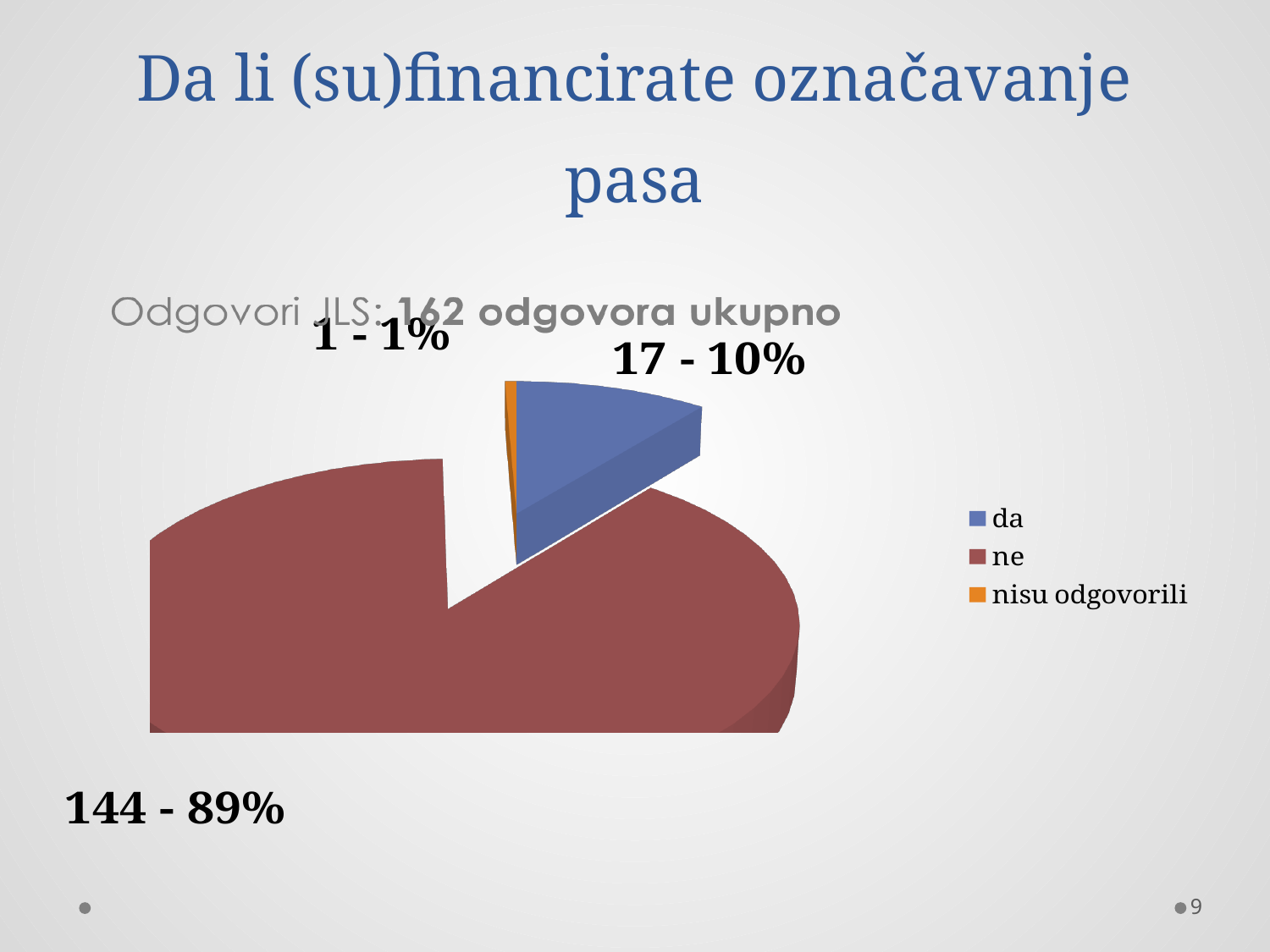
What is the count and percentage shown for the 'nisu odgovorili' slice? 1 - 1% What kind of chart is shown on the slide? pie chart What share of the pie does the 'da' slice represent? 10% Which category has the smallest slice of the pie? nisu odgovorili What colour is the 'ne' slice in the pie chart? dark red What is the difference in count between the 'ne' and 'da' slices? 127 How many entries does the legend list? 3 Which category has the largest slice of the pie? ne How many slices does the pie chart have? 3 Which is larger, the 'da' slice or the 'nisu odgovorili' slice? da What is the count and percentage shown for the 'ne' slice? 144 - 89% What is the count and percentage shown for the 'da' slice? 17 - 10%